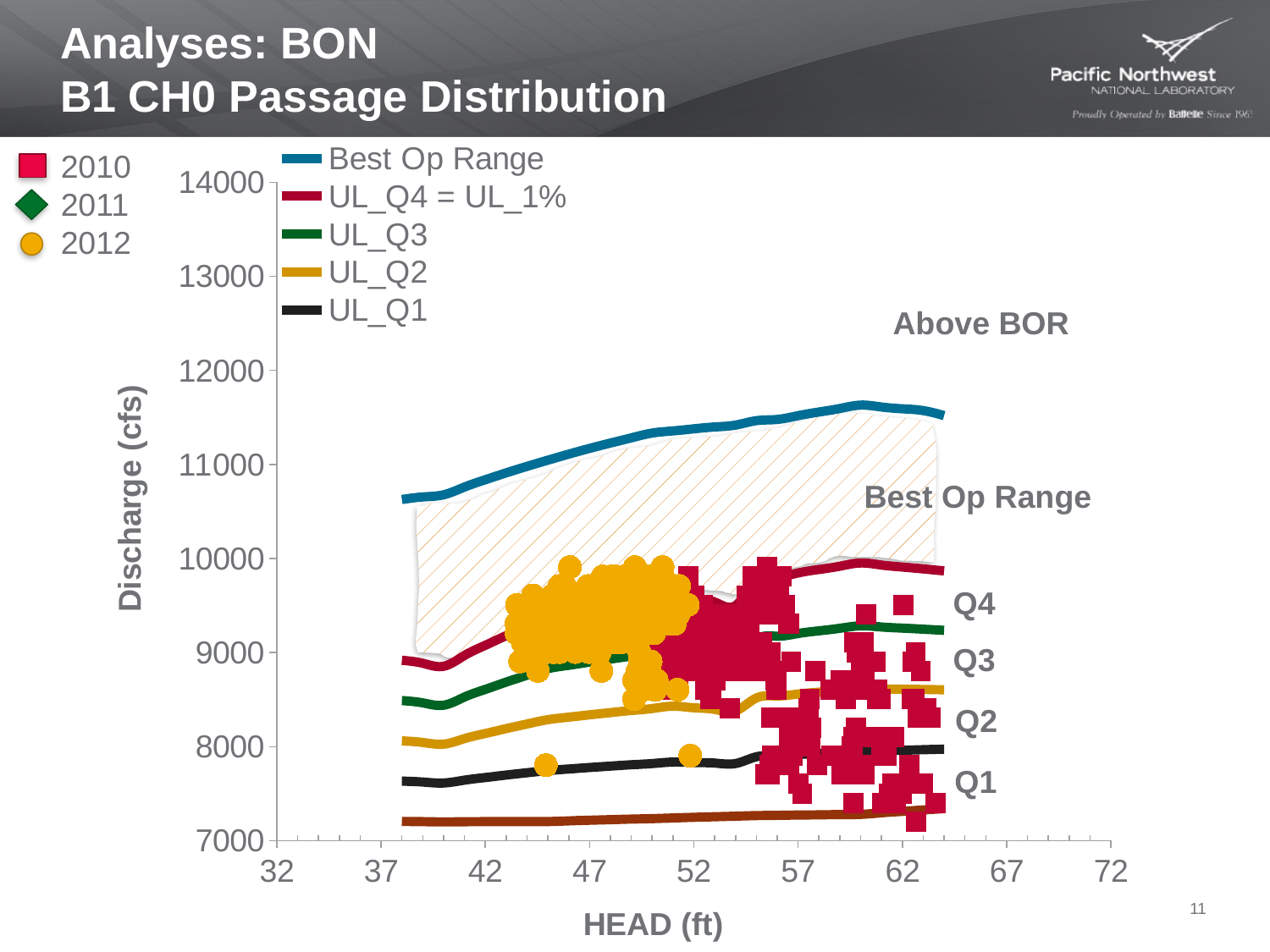
Is the UL_Q2 line at a head of 57 ft greater or less than 8000 cfs? greater Which line is higher at a head of 57 ft, Best Op Range or UL_Q4? Best Op Range Does the Best Op Range line generally rise or fall as head increases from 38 ft to 60 ft? rise How many years does the year legend list? 3 Which of the five legend lines is the highest on the chart? Best Op Range Which line is higher at a head of 52 ft, UL_Q3 or UL_Q2? UL_Q3 What is the title of the x axis? HEAD (ft) Is the UL_Q3 line at a head of 62 ft greater or less than 9000 cfs? greater How many line series does the main legend list? 5 Is the Best Op Range line at a head of 62 ft greater or less than 11000 cfs? greater What is the title of the y axis? Discharge (cfs)